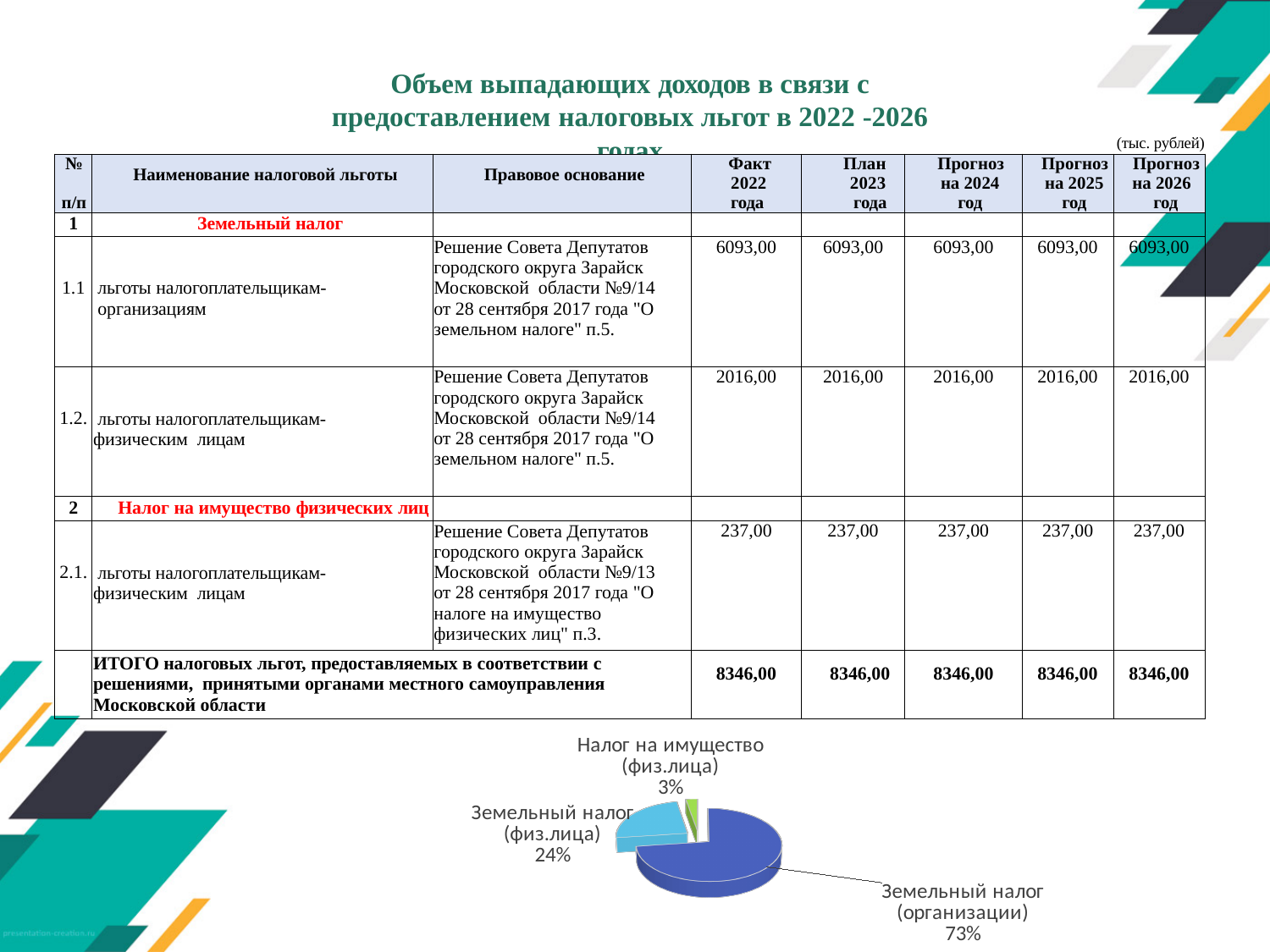
In the pie chart, which is larger: the share for Земельный налог (физ.лица) or the share for Налог на имущество (физ.лица)? Земельный налог (физ.лица) What share of the pie chart is labelled "Земельный налог (организации)"? 73% In the pie chart, is the share for Земельный налог (организации) greater or less than 50%? greater In the pie chart, what is the difference in percentage points between the share for Земельный налог (физ.лица) and the share for Налог на имущество (физ.лица)? 21 What kind of chart is shown at the bottom of the slide? pie chart What share of the pie chart is labelled "Налог на имущество (физ.лица)"? 3% Which slice of the pie chart is the largest? Земельный налог (организации) In the pie chart, what is the difference in percentage points between the share for Земельный налог (организации) and the share for Земельный налог (физ.лица)? 49 Which slice of the pie chart is the smallest? Налог на имущество (физ.лица) What colour is the largest slice of the pie chart? blue What share of the pie chart is labelled "Земельный налог (физ.лица)"? 24% How many slices does the pie chart have? 3